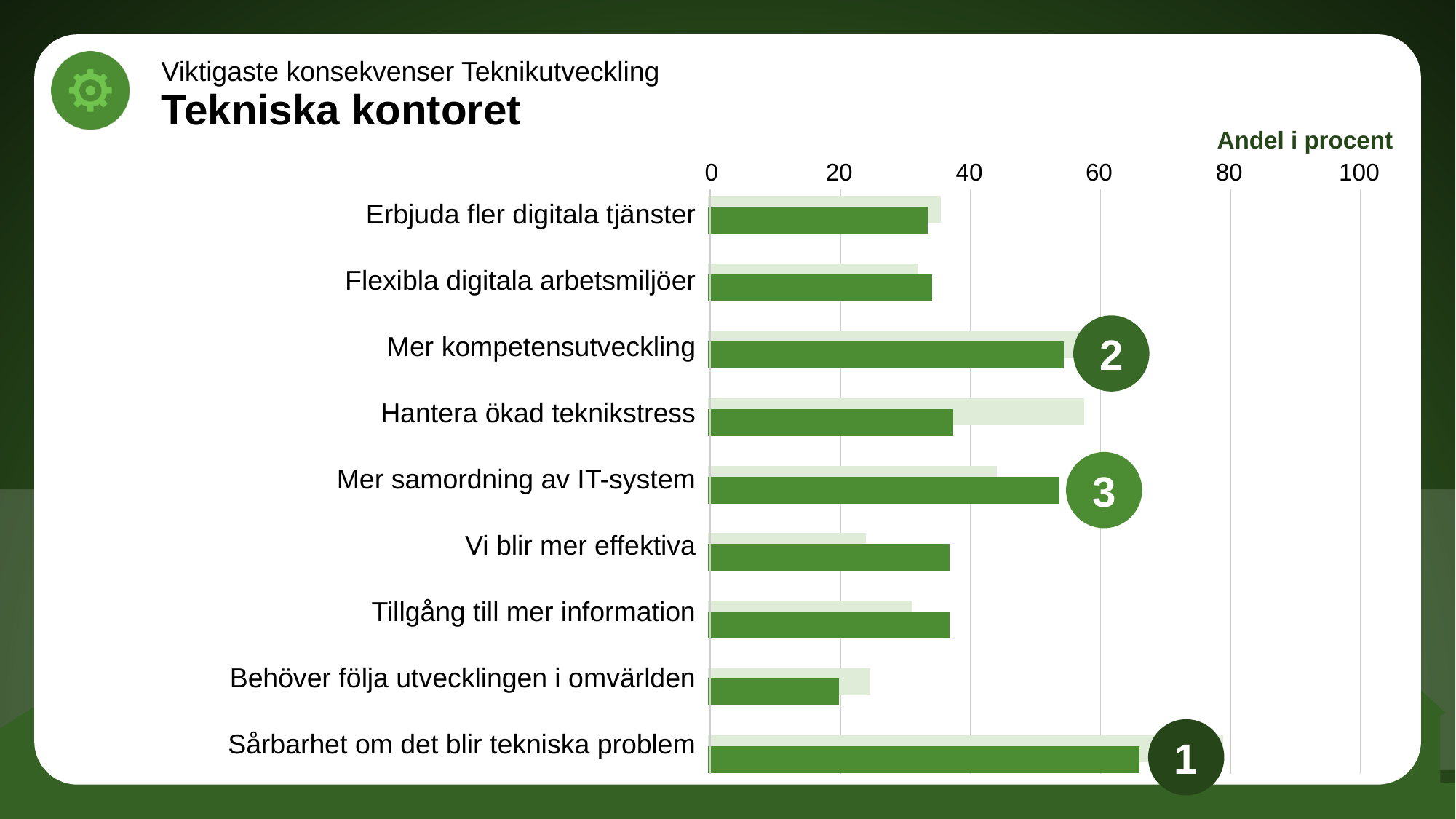
Which category has the shortest dark green bar? Behöver följa utvecklingen i omvärlden Is the dark green bar for Sårbarhet om det blir tekniska problem greater or less than 60? greater What is the label shown above the horizontal axis? Andel i procent Is the light green bar for Hantera ökad teknikstress greater or less than 40? greater What kind of chart is shown on the slide? Bar chart Which has the longer dark green bar: Mer kompetensutveckling or Hantera ökad teknikstress? Mer kompetensutveckling Is the dark green bar for Mer kompetensutveckling greater or less than 40? greater How many categories are listed on the chart? 9 Which category has the longest dark green bar? Sårbarhet om det blir tekniska problem For Vi blir mer effektiva, which bar is longer: the dark green or the light green? Dark green Which category is marked with the number 1 badge? Sårbarhet om det blir tekniska problem